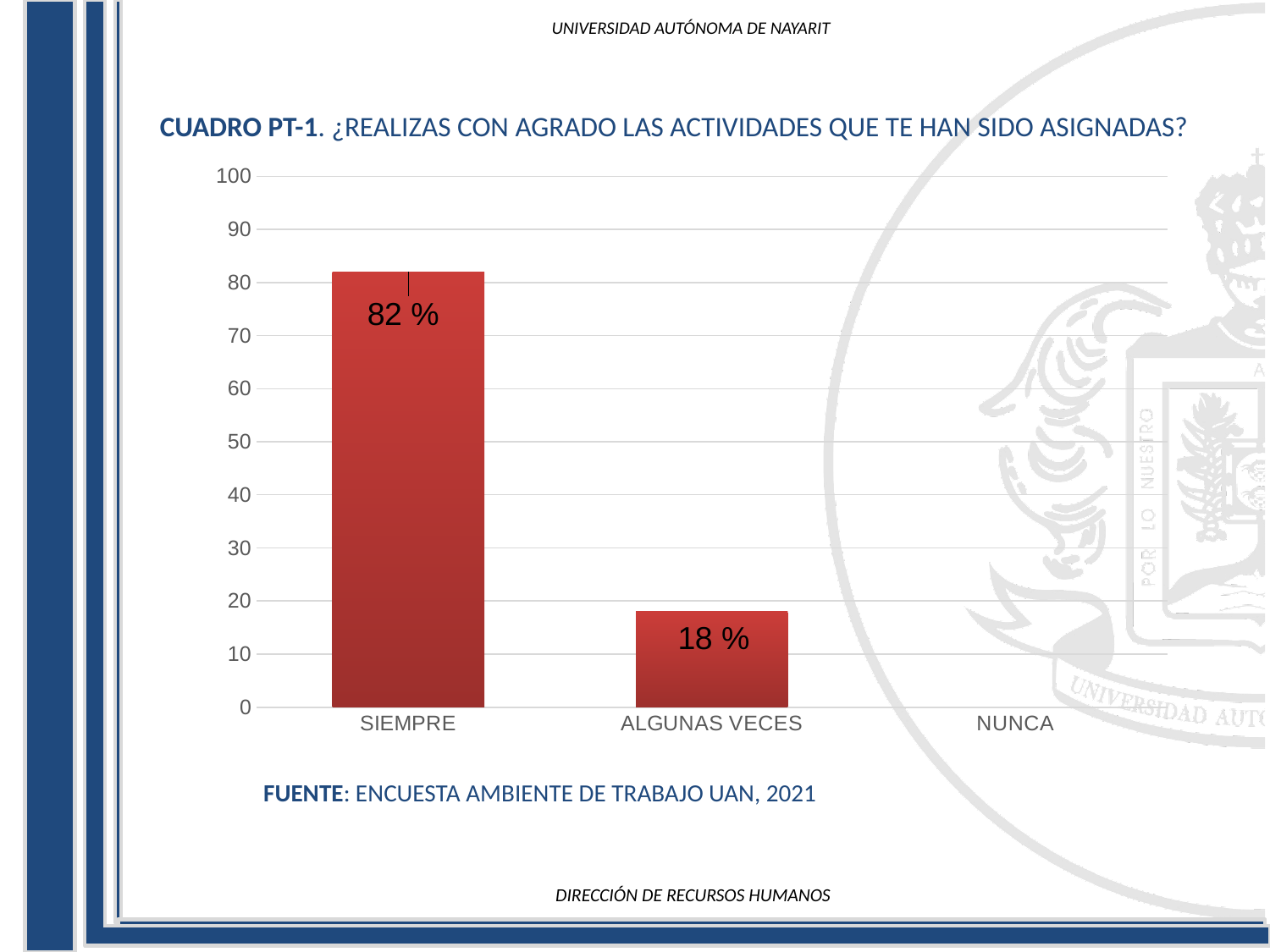
Which category has the highest value? SIEMPRE What is the source cited below the chart? ENCUESTA AMBIENTE DE TRABAJO UAN, 2021 Is the value for SIEMPRE greater or less than 50? greater What is the value for SIEMPRE? 82 % What is the value for ALGUNAS VECES? 18 % Do the values rise or fall from left to right along the x axis? fall What kind of chart is shown on the slide? bar chart Which is larger, the value for SIEMPRE or the value for ALGUNAS VECES? SIEMPRE What is the difference between the values for SIEMPRE and ALGUNAS VECES? 64 % How many categories are shown on the x axis? 3 Is the value for ALGUNAS VECES greater or less than 20? less